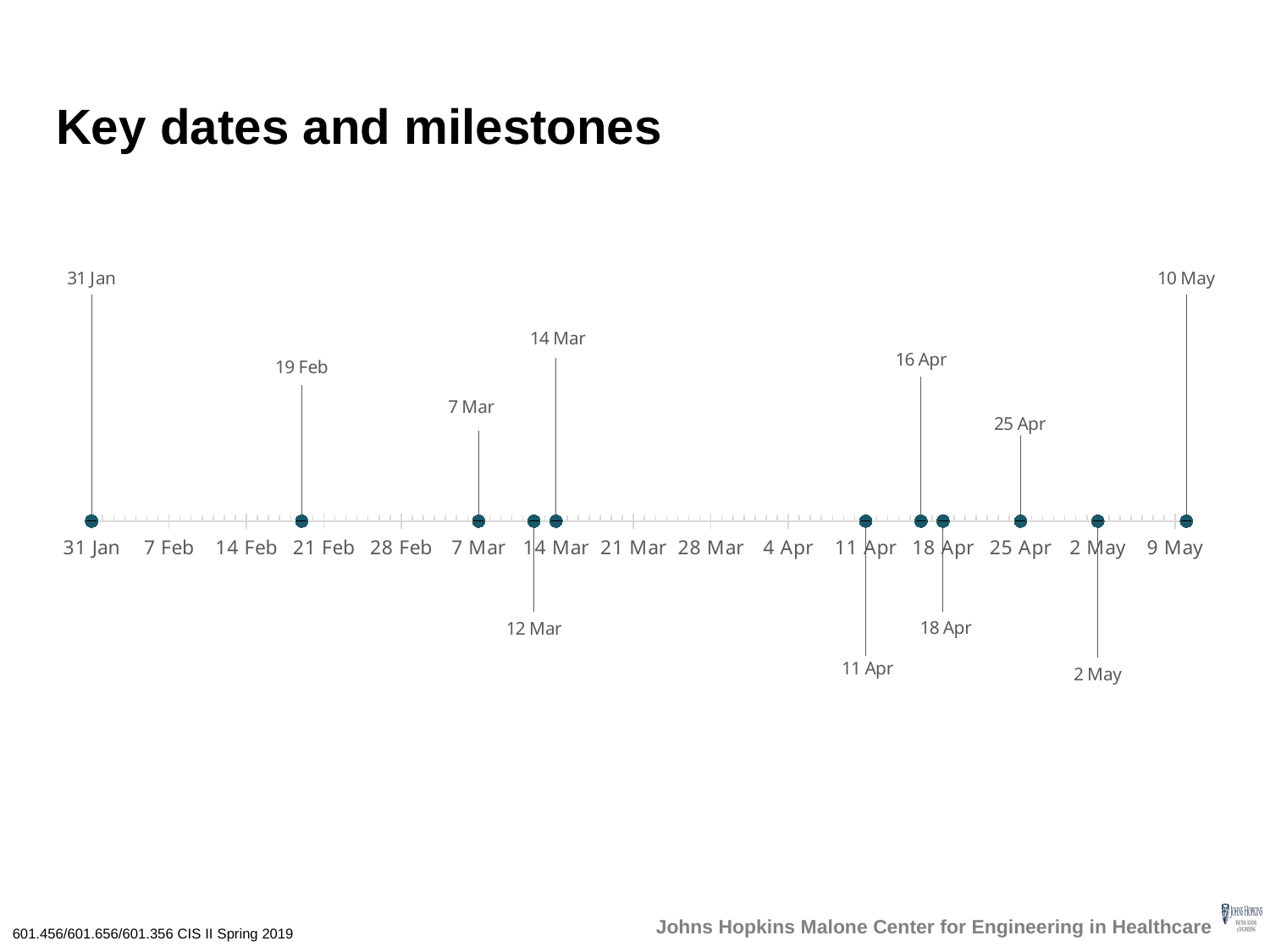
What is the only milestone date in February on the timeline? 19 Feb How many milestones fall in April on the timeline? 4 What is the title of the chart on the slide? Key dates and milestones How many milestone points are plotted on the timeline? 11 How many days are there between the 12 Mar and 14 Mar milestones? 2 days What is the latest milestone date on the timeline? 10 May Which milestone comes first, 16 Apr or 18 Apr? 16 Apr What kind of chart is shown on the slide? Timeline chart What is the first tick label on the timeline's horizontal axis? 31 Jan Which milestone date is labelled between 7 Mar and 14 Mar on the timeline? 12 Mar What is the earliest milestone date on the timeline? 31 Jan How many milestones fall in March on the timeline? 3